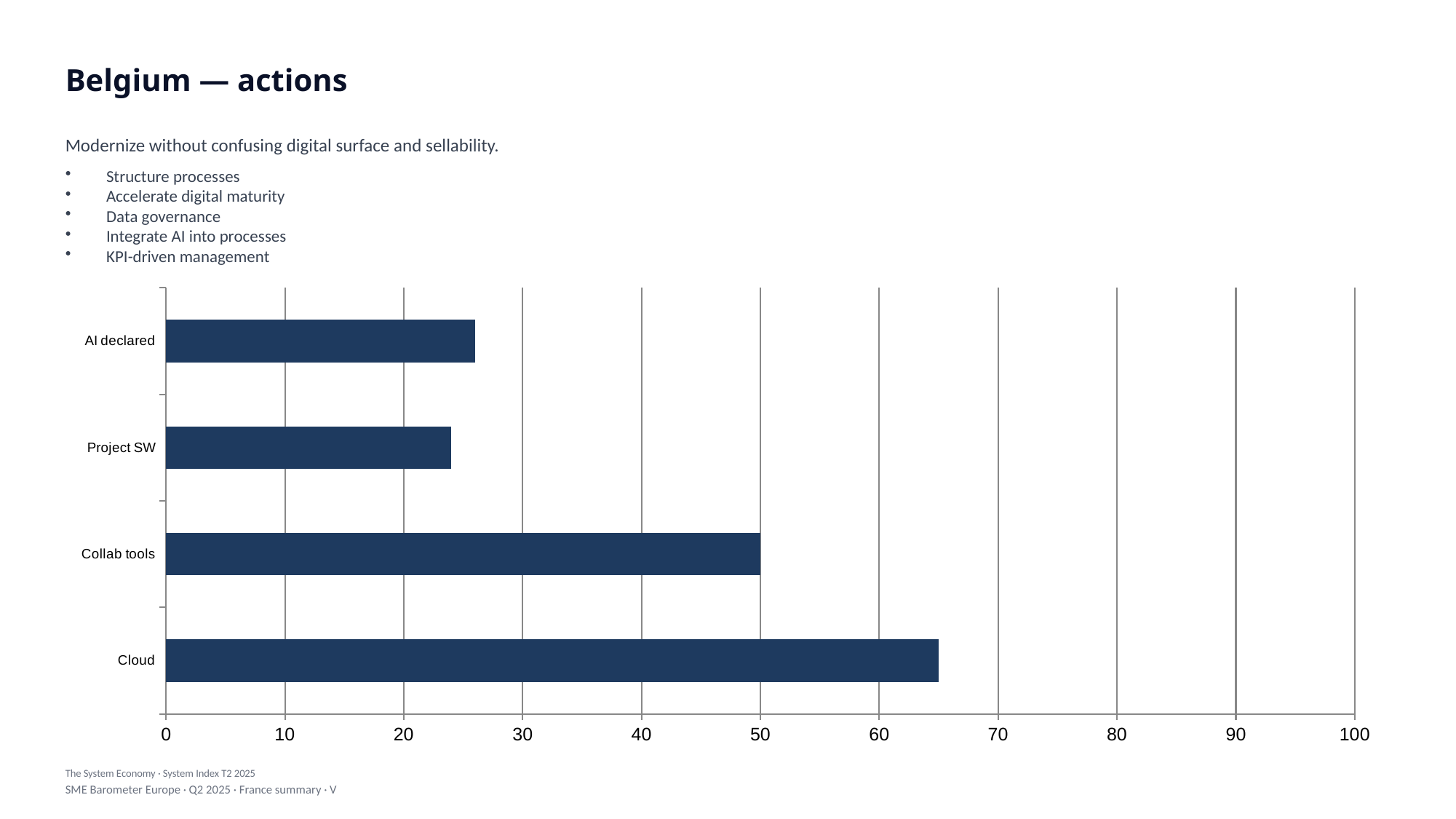
What is the value for Collab tools? 50 Which category has the highest value in the chart? Cloud What is the maximum value shown on the horizontal axis of the chart? 100 Which is larger, the value for Cloud or the value for Collab tools? Cloud Is the value for Cloud greater or less than 70? less What kind of chart is shown on the slide? bar chart Is the value for Project SW greater or less than 20? greater What is the title of the slide containing the chart? Belgium — actions Is the value for AI declared greater or less than 30? less Which is larger, the value for Collab tools or the value for AI declared? Collab tools How many categories are plotted in the chart? 4